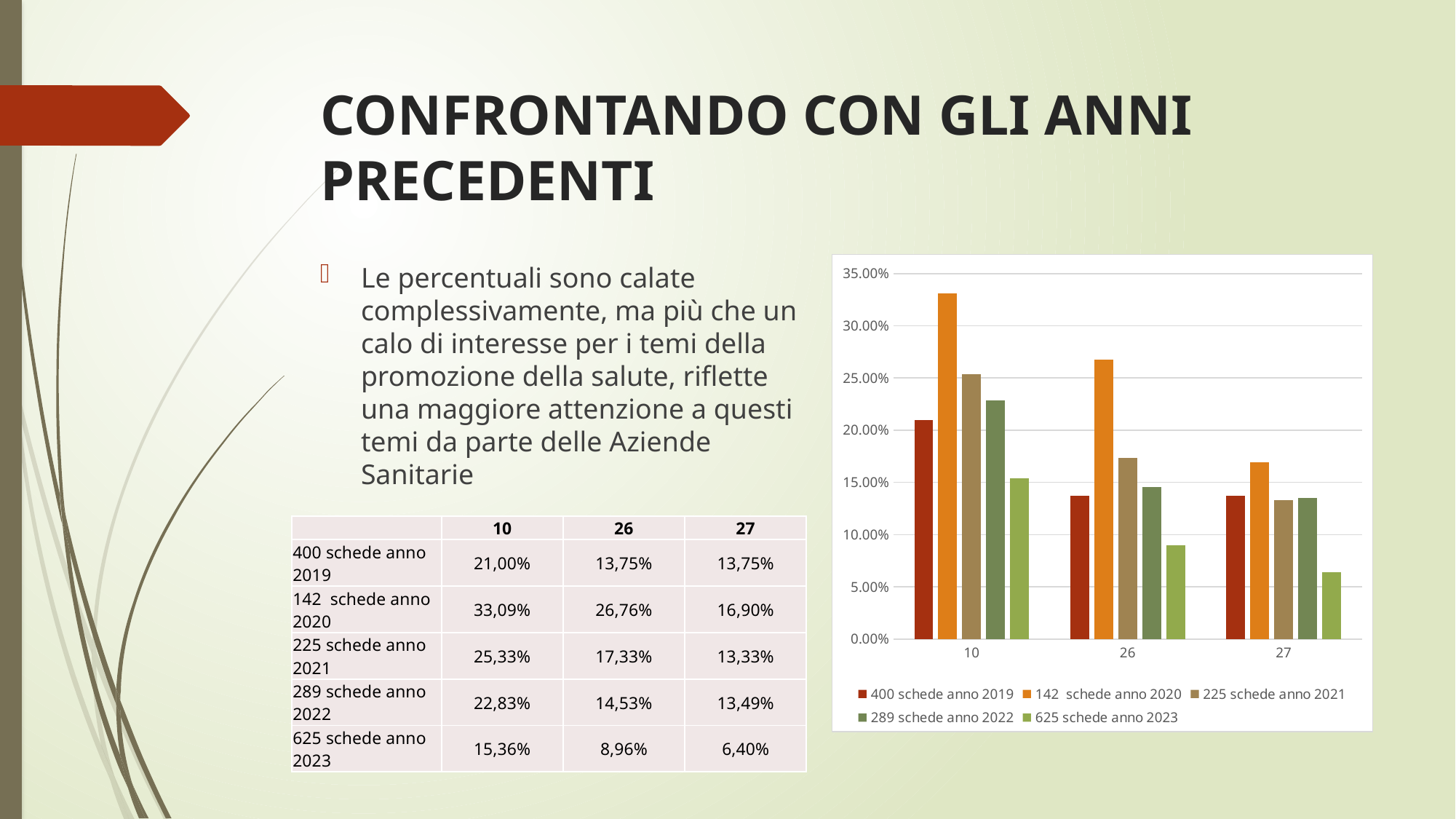
How many categories are shown on the x axis of the chart? 3 Is the value for '142 schede anno 2020' at category 10 greater or less than 30.00%? greater Using the table values, what is the difference between '142 schede anno 2020' and '400 schede anno 2019' at category 10? 12,09% What kind of chart is shown on the slide? bar chart At category 26, which is larger: '225 schede anno 2021' or '289 schede anno 2022'? 225 schede anno 2021 According to the table, what is the value for '142 schede anno 2020' at category 26? 26,76% What colour represents '142 schede anno 2020' in the chart? orange Which series has the highest bar for category 10? 142 schede anno 2020 Do the values for '625 schede anno 2023' rise or fall across categories 10, 26 and 27? fall Which series has the lowest bar for category 27? 625 schede anno 2023 How many series does the chart legend list? 5 Is the value for '625 schede anno 2023' at category 27 greater or less than 10.00%? less